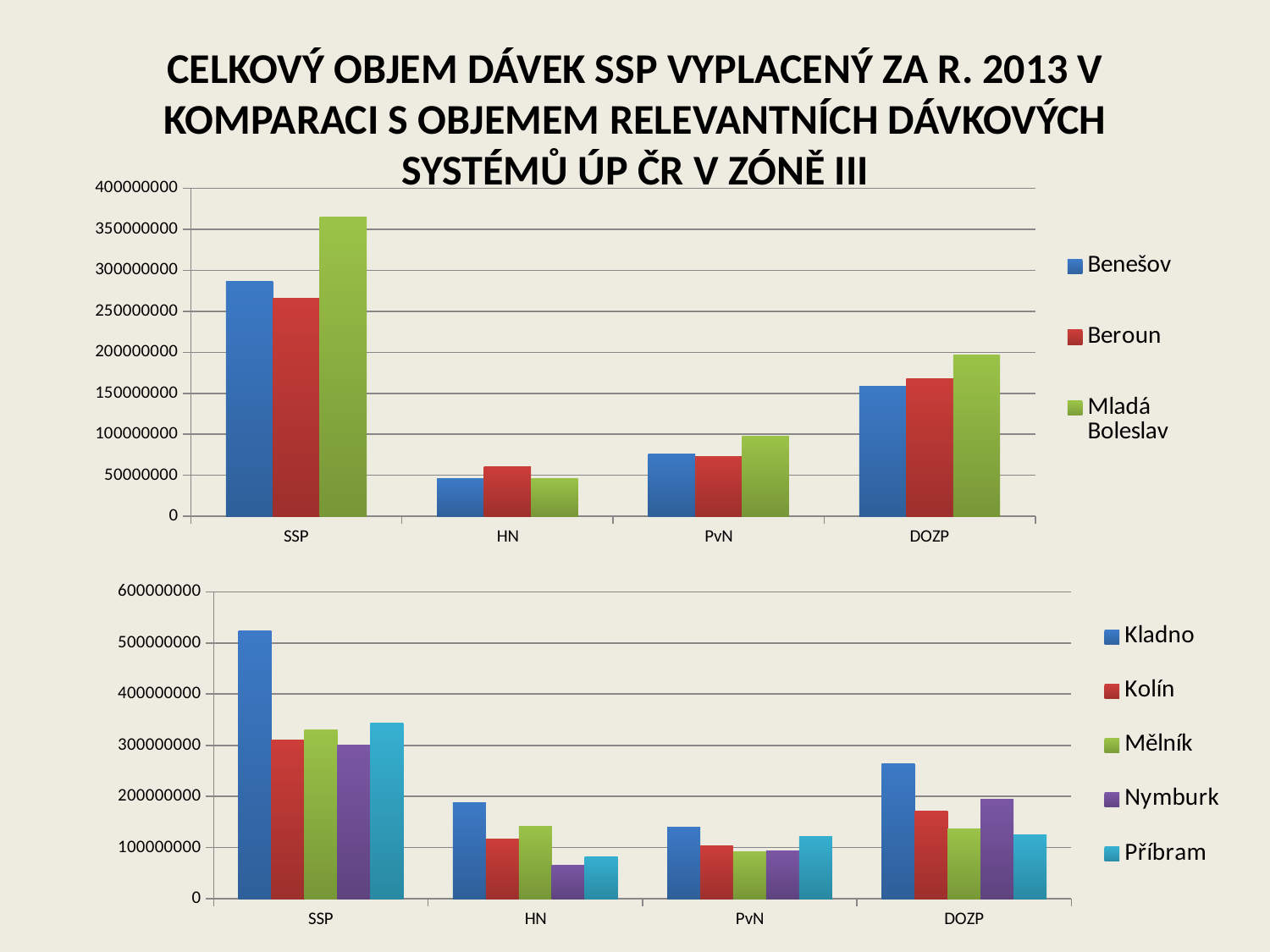
In the bottom chart, which is larger in the DOZP category: Nymburk or Mělník? Nymburk How many categories are shown on the x axis of the bottom chart? 4 How many series does the legend of the top chart list? 3 In the bottom chart, which series has the highest value in the SSP category? Kladno In the bottom chart, which series has the lowest value in the HN category? Nymburk In the top chart, is the value for Benešov in the SSP category greater or less than 300000000? less In the top chart, which category has the lowest value for Benešov? HN How many series does the legend of the bottom chart list? 5 In the bottom chart, is the value for Kladno in the SSP category greater or less than 500000000? greater In the top chart, is the value for Mladá Boleslav in the SSP category greater or less than 350000000? greater In the top chart, which series has the highest value in the DOZP category? Mladá Boleslav What kind of chart is the top chart on the slide? bar chart